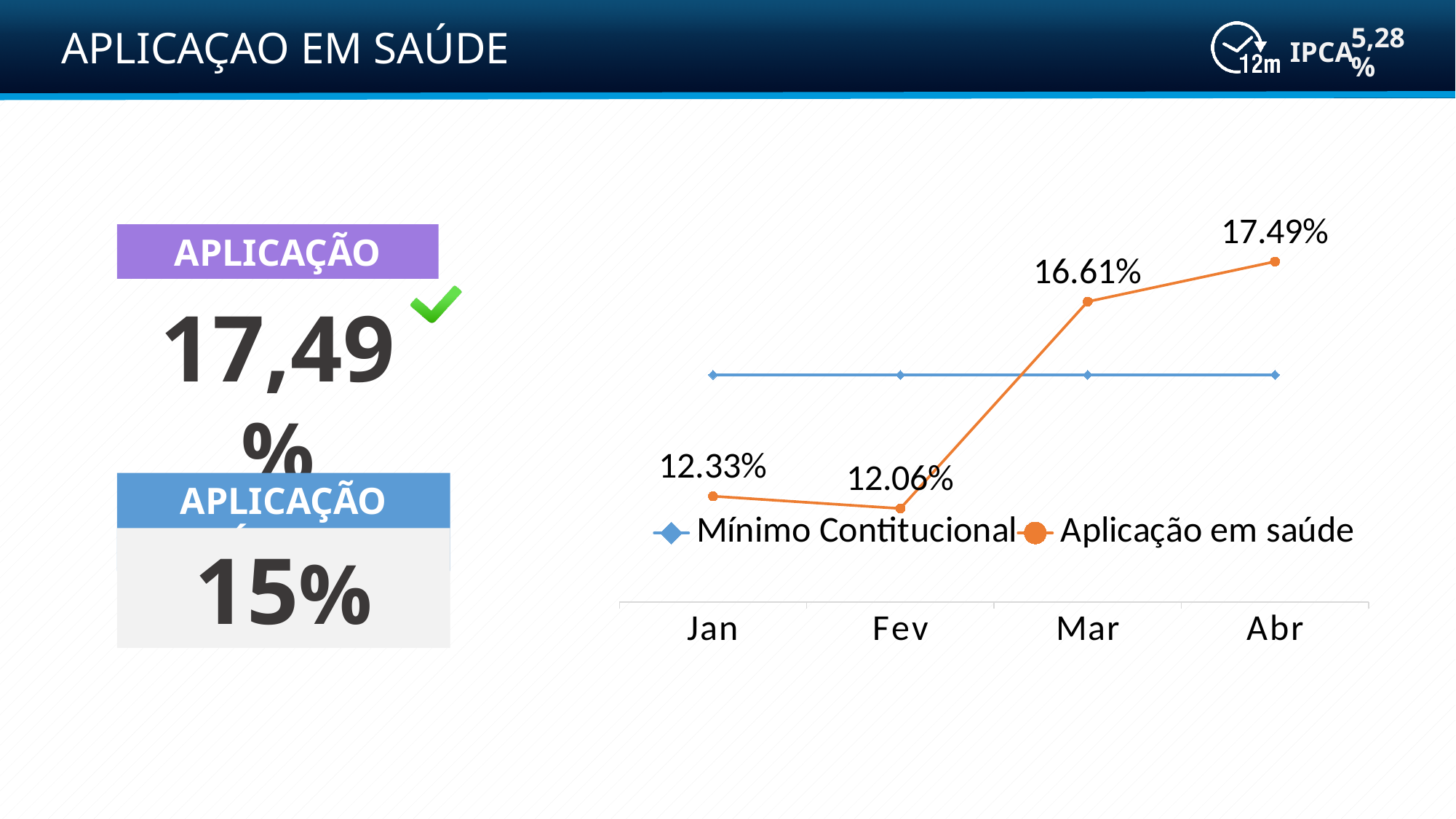
What is the value of Aplicação em saúde in Mar? 16.61% What kind of chart is shown? Line chart How many months are shown on the x axis? 4 What is the value of Aplicação em saúde in Fev? 12.06% What is the difference between the Aplicação em saúde values for Abr and Jan? 5.16 percentage points Which is larger for Aplicação em saúde: Jan or Fev? Jan In which month is Aplicação em saúde lowest? Fev Does the Aplicação em saúde line rise or fall from Fev to Abr? Rise What is the value of Aplicação em saúde in Jan? 12.33% How many series does the legend list? 2 What is the value of Aplicação em saúde in Abr? 17.49% In which month is Aplicação em saúde highest? Abr